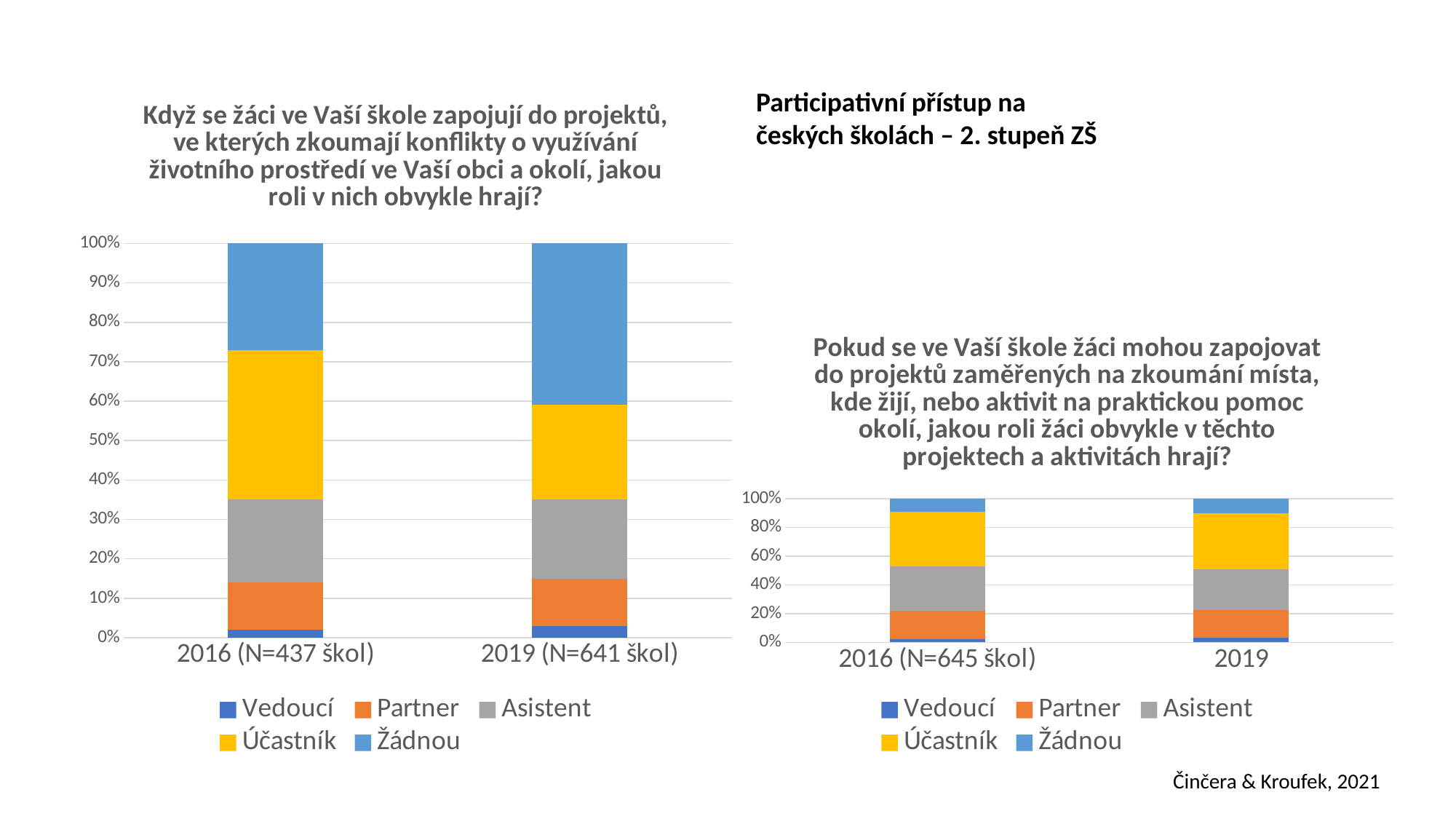
In the left chart, which series is the smallest segment of the 2016 (N=437 škol) bar? Vedoucí How many bars (categories) are plotted in the right chart? 2 In the right chart, is the Partner share for 2019 greater or less than 40%? less What kind of chart is the chart on the left of the slide? Stacked bar chart In the right chart, is the Žádnou share for 2016 (N=645 škol) greater or less than 20%? less In the left chart, is the Žádnou share for 2019 (N=641 škol) greater or less than 30%? greater In the left chart, is the Účastník share larger in 2016 (N=437 škol) or in 2019 (N=641 škol)? 2016 (N=437 škol) In the left chart, what is the label of the first category on the x axis? 2016 (N=437 škol) How many series does the legend of the left chart list? 5 In the right chart, what is the label of the first category on the x axis? 2016 (N=645 škol) In the left chart, is the Žádnou share larger in 2016 (N=437 škol) or in 2019 (N=641 škol)? 2019 (N=641 škol)